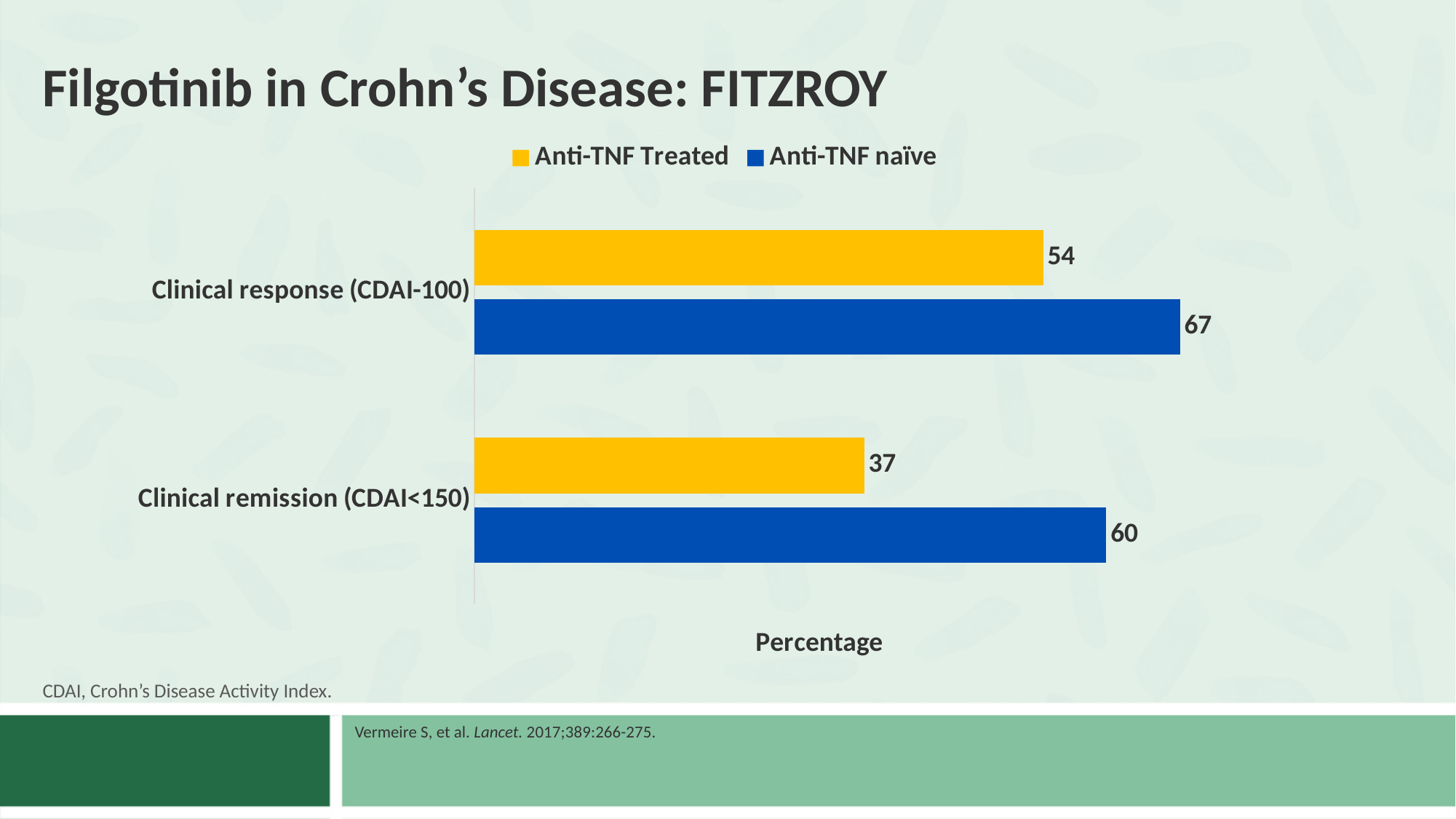
How many series does the legend list? 2 What is the value for Anti-TNF Treated in Clinical response (CDAI-100)? 54 Which bar has the highest value on the chart? Anti-TNF naïve, Clinical response (CDAI-100) How many categories are shown on the chart? 2 Which is larger for Clinical remission (CDAI<150): Anti-TNF Treated or Anti-TNF naïve? Anti-TNF naïve Which bar has the lowest value on the chart? Anti-TNF Treated, Clinical remission (CDAI<150) What is the value for Anti-TNF naïve in Clinical response (CDAI-100)? 67 What is the value for Anti-TNF Treated in Clinical remission (CDAI<150)? 37 What kind of chart is shown on the slide? Bar chart What is the difference between Anti-TNF naïve and Anti-TNF Treated for Clinical response (CDAI-100)? 13 What is the value for Anti-TNF naïve in Clinical remission (CDAI<150)? 60 What is the difference between Anti-TNF naïve and Anti-TNF Treated for Clinical remission (CDAI<150)? 23